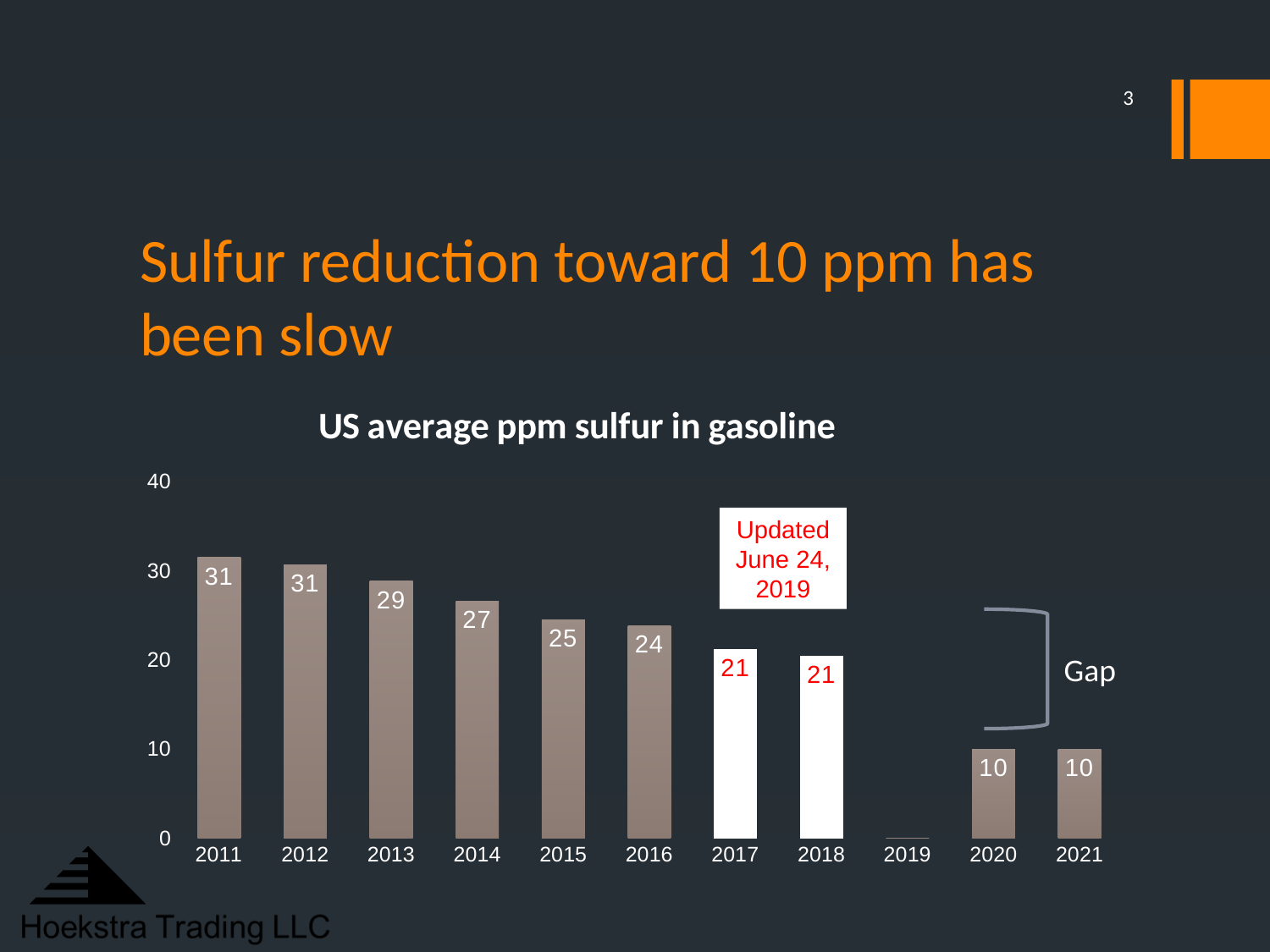
Which year has the lowest labelled value on the chart? 2020 and 2021 (10) What is the US average ppm sulfur in gasoline for 2013? 29 What value is shown for 2016? 24 What value is shown for 2018? 21 Is the value for 2015 greater or less than 20? greater What is the difference between the values for 2011 and 2017? 10 What is the difference between the values for 2014 and 2015? 2 Which is larger, the value for 2013 or the value for 2016? 2013 What kind of chart is this? bar chart How many years are shown on the x axis? 11 Do the values generally rise or fall from 2011 to 2018? fall What value is shown for 2021? 10